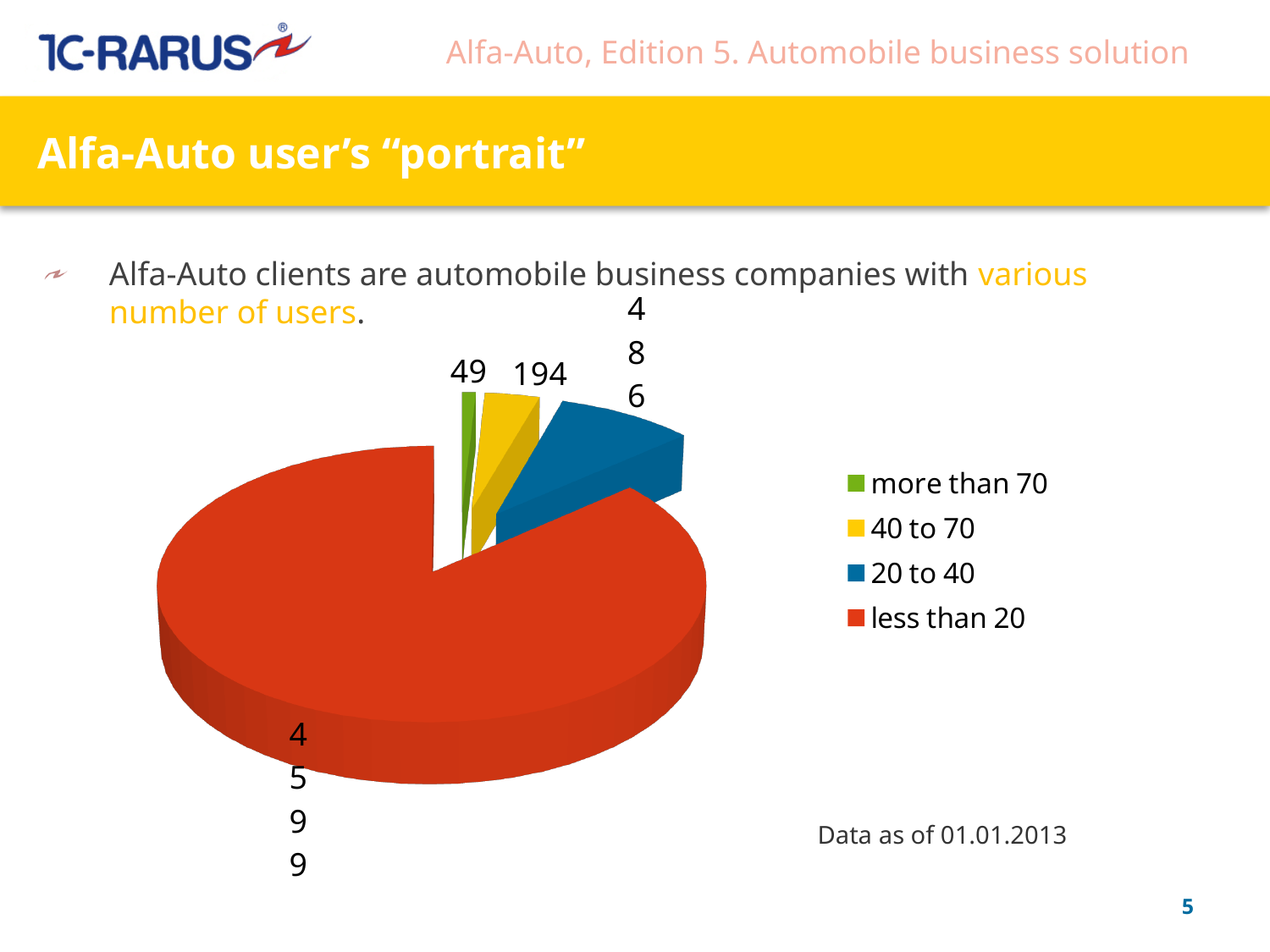
Which is larger, the value for "40 to 70" or the value for "more than 70"? 40 to 70 What is the value for the "more than 70" slice? 49 Which category has the largest slice of the pie? less than 20 What is the difference between the values for "40 to 70" and "more than 70"? 145 What is the value for the "less than 20" slice? 4599 What kind of chart is shown on the slide? pie chart What is the value for the "40 to 70" slice? 194 What is the value for the "20 to 40" slice? 486 How many slices does the pie chart have? 4 What colour is the "less than 20" slice? red Which category has the smallest slice of the pie? more than 70 How many entries does the legend list? 4